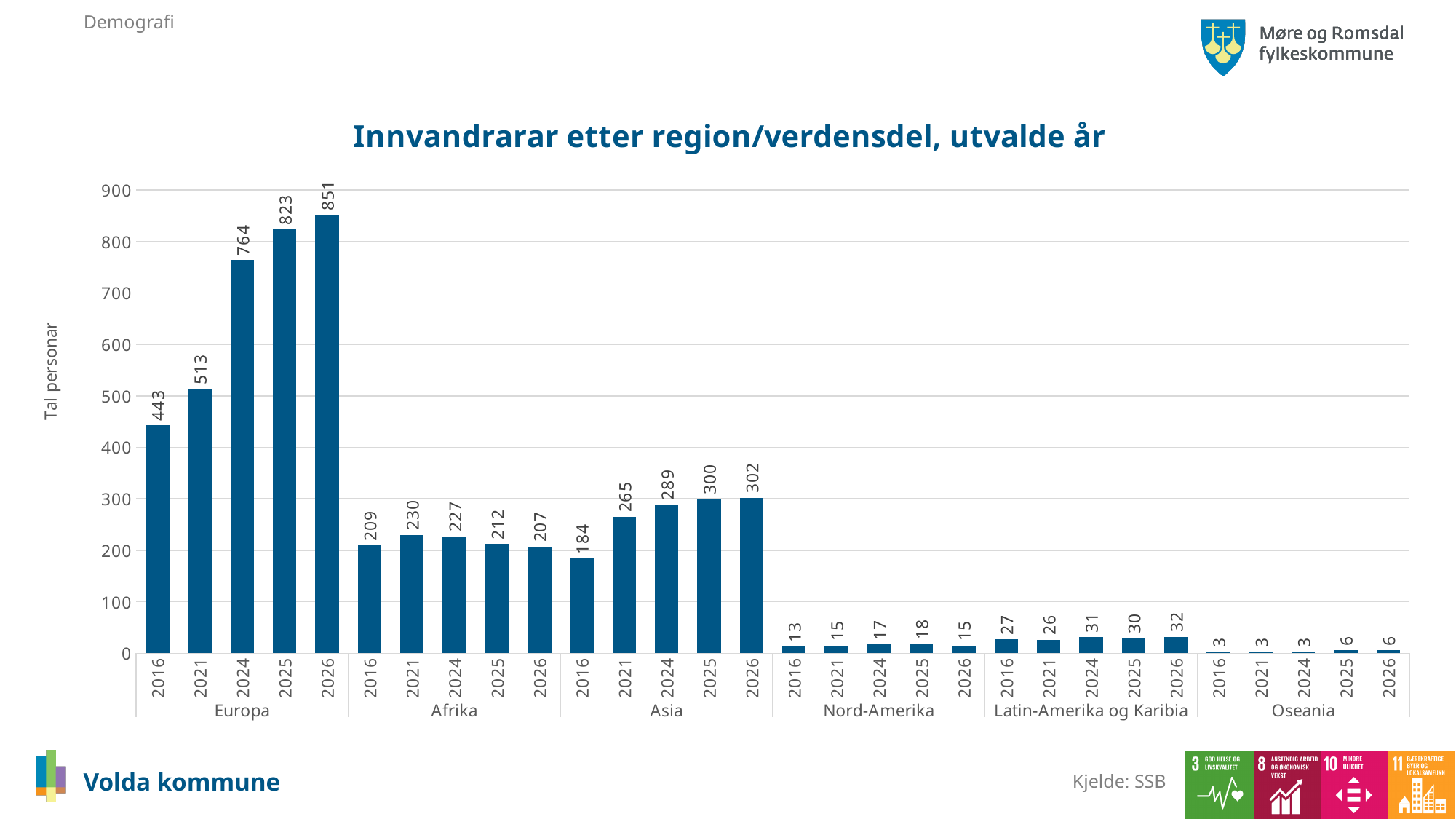
Which is larger, the Afrika value for 2021 or the Asia value for 2021? Asia value for 2021 Do the values for Europa rise or fall from 2016 to 2026? Rise Is the value for Europa in 2024 greater or less than 700? greater What is the difference between the Europa values for 2026 and 2016? 408 What is the title of the chart? Innvandrarar etter region/verdensdel, utvalde år What is the value for Asia in 2016? 184 How many regions are shown on the x axis? 6 What is the value for Nord-Amerika in 2025? 18 Which region has the highest bar in 2024? Europa What is the value for Europa in 2026? 851 What kind of chart is shown on the slide? Bar chart Which region has the lowest value in 2021? Oseania